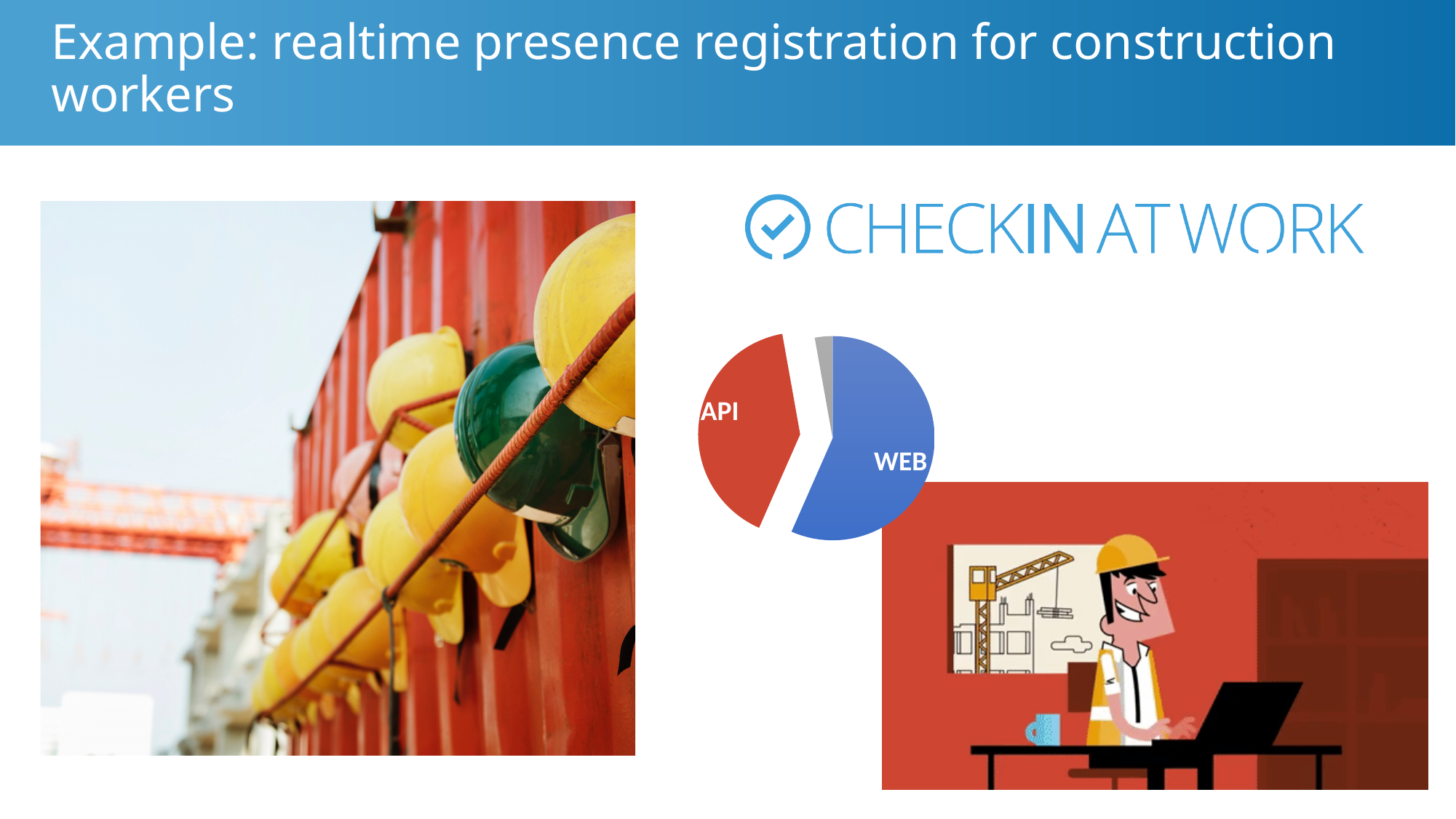
What colour is the API slice of the pie chart? red How many slices of the pie chart have a text label? 2 Which is larger in the pie chart, API or WEB? WEB How many slices does the pie chart have? 3 Which labelled slice of the pie chart is the largest? WEB What kind of chart is shown on the slide? pie chart Which of the two labelled slices, API or WEB, is smaller? API What colour is the WEB slice of the pie chart? blue